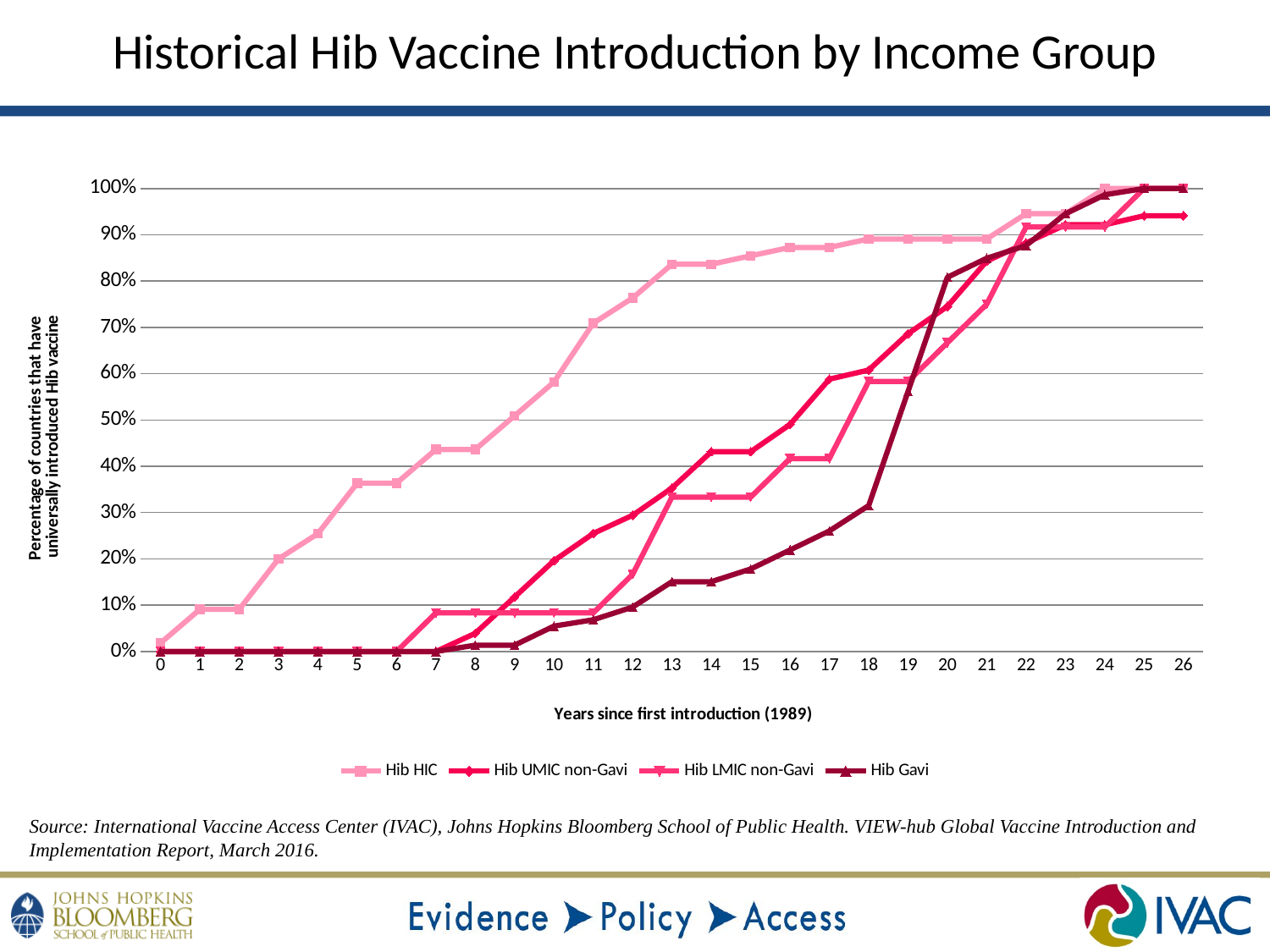
What kind of chart is shown on the slide? line chart What is the title of the x axis? Years since first introduction (1989) What is the value for Hib Gavi at year 26? 100% Is the value for Hib HIC at year 13 greater or less than 80%? greater Which series has the lowest value at year 15? Hib Gavi How many series does the legend list? 4 How many points (years since first introduction) are plotted along the x axis? 27 Is the value for Hib Gavi at year 17 greater or less than 30%? less Which series has the highest value at year 10? Hib HIC What is the value for Hib Gavi at year 0? 0% Is the value for Hib LMIC non-Gavi at year 12 greater or less than 20%? less At year 20, which is larger: Hib Gavi or Hib LMIC non-Gavi? Hib Gavi